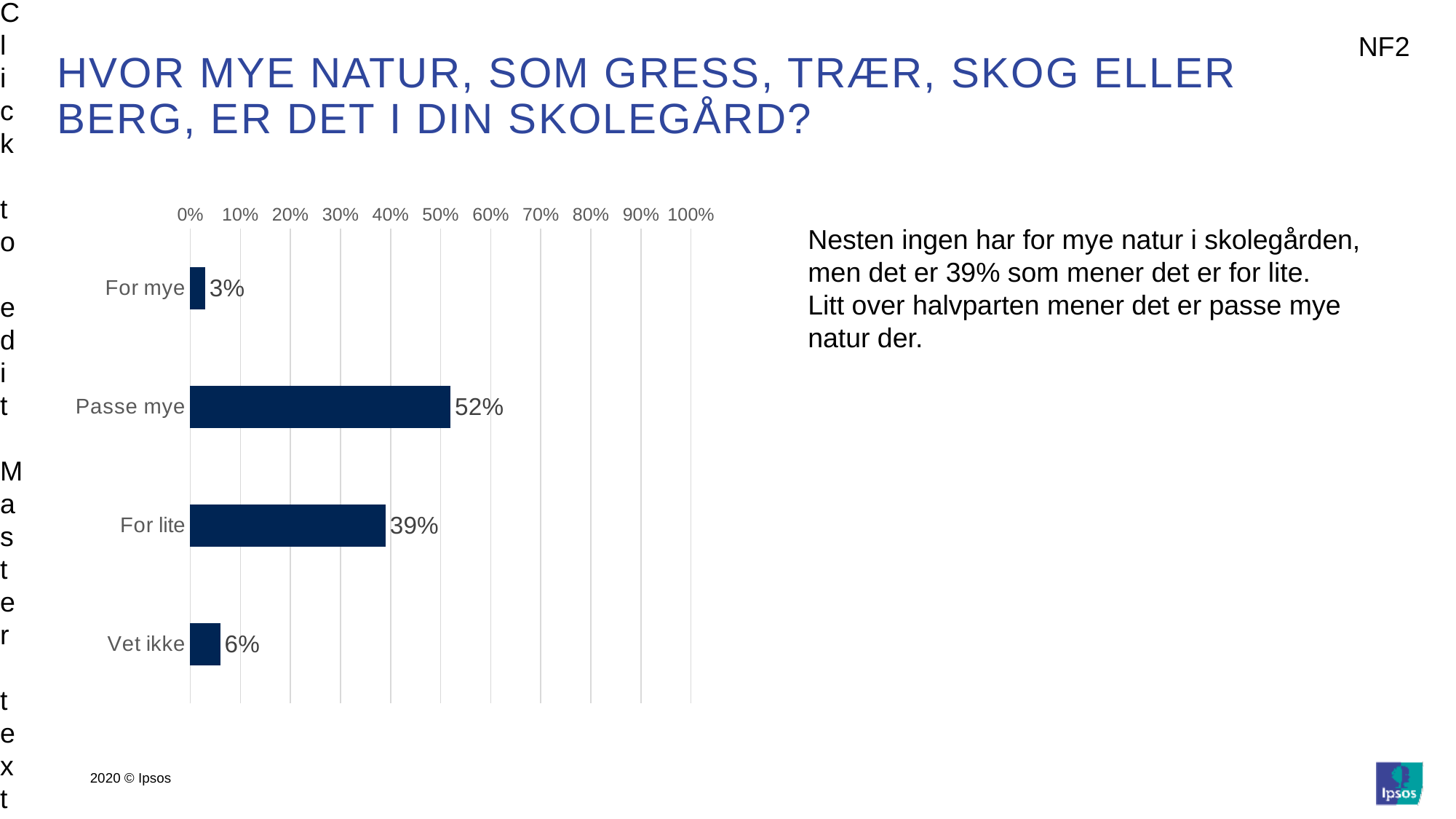
What is the value for "For mye"? 3% What is the value for "Passe mye"? 52% What kind of chart is shown on the slide? bar chart What is the difference between the values for "Passe mye" and "For lite"? 13% What is the value for "For lite"? 39% Which category has the lowest value? For mye Which category has the highest value? Passe mye Is the value for "Passe mye" greater or less than 50%? greater What is the value for "Vet ikke"? 6% Which is larger, the value for "Vet ikke" or the value for "For mye"? Vet ikke How many categories are shown in the chart? 4 What is the highest value shown on the percentage axis? 100%